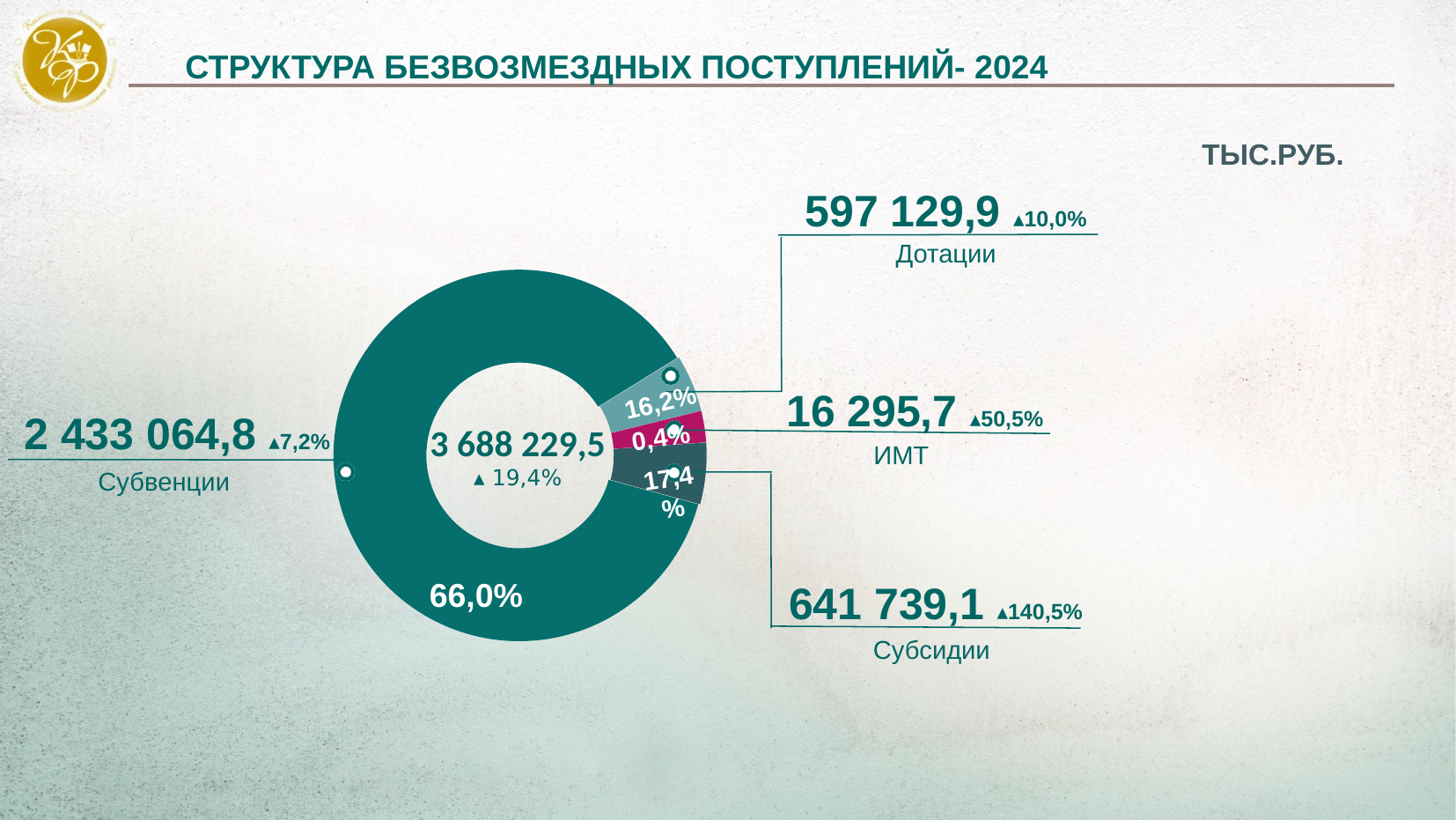
What share of the donut does Субсидии take? 17,4% What is the value for Дотации? 597 129,9 What total value is shown in the centre of the donut? 3 688 229,5 Which category has the smallest share of the donut? ИМТ What is the value for Субвенции? 2 433 064,8 Which category has the largest share of the donut? Субвенции What kind of chart is shown on the slide? Donut (pie) chart What is the value for Субсидии? 641 739,1 What share of the donut does Субвенции take? 66,0% Which is larger, the value for Субсидии or the value for Дотации? Субсидии What is the value for ИМТ? 16 295,7 How many categories are shown in the donut chart? 4